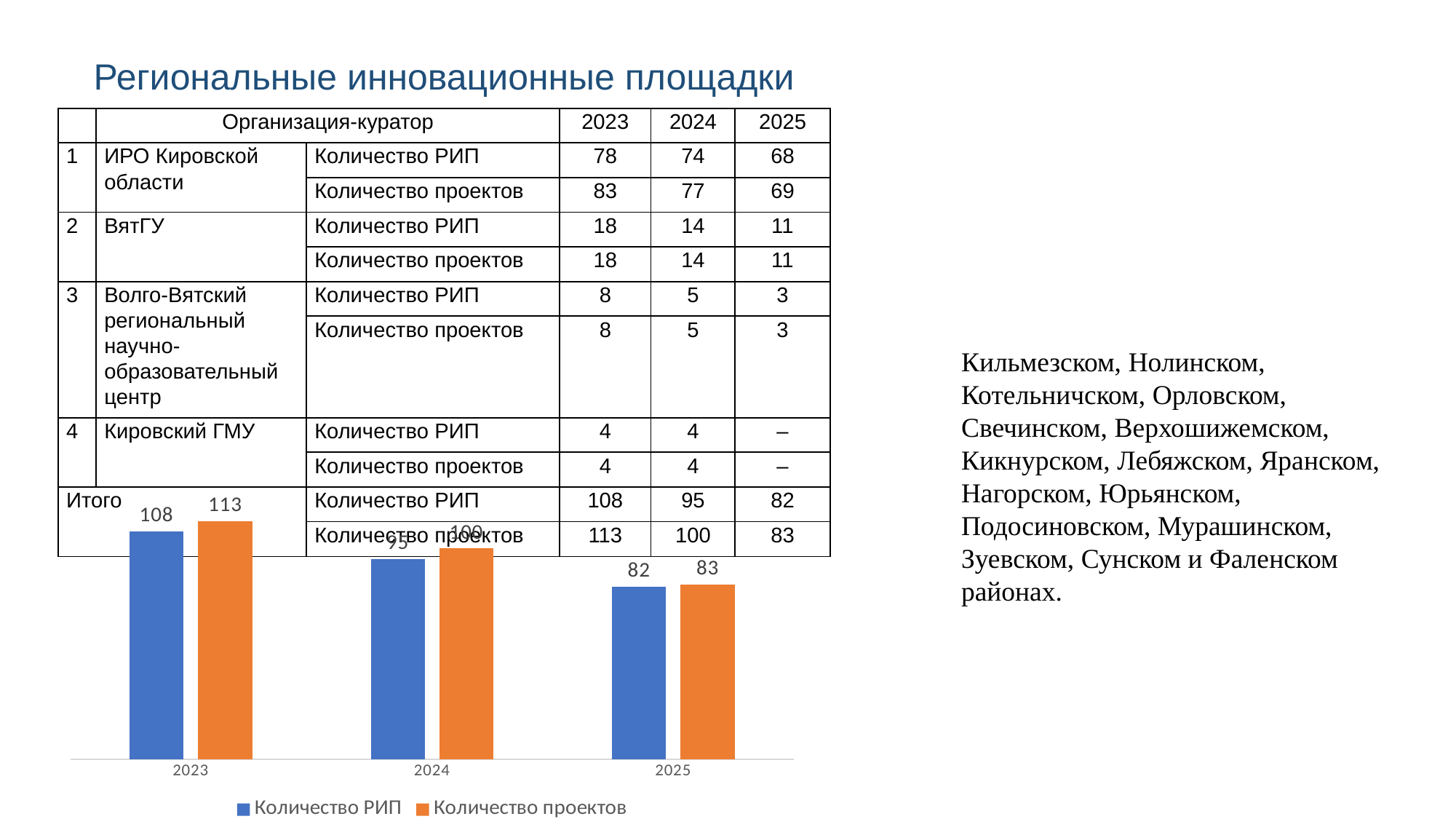
What is the difference between Количество проектов and Количество РИП for 2023 in the chart? 5 What is the value of Количество проектов for 2025 in the chart? 83 What type of chart is shown on the slide? bar chart How many categories are shown on the x axis of the chart? 3 Which year has the highest value for Количество РИП in the chart? 2023 What is the value of Количество РИП for 2025 in the chart? 82 What is the value of Количество проектов for 2023 in the chart? 113 How many series does the chart legend list? 2 Which year has the lowest value for Количество проектов in the chart? 2025 Which colour represents Количество проектов in the chart? orange Does Количество РИП rise or fall from 2023 to 2025 in the chart? fall What is the value of Количество РИП for 2023 in the chart? 108